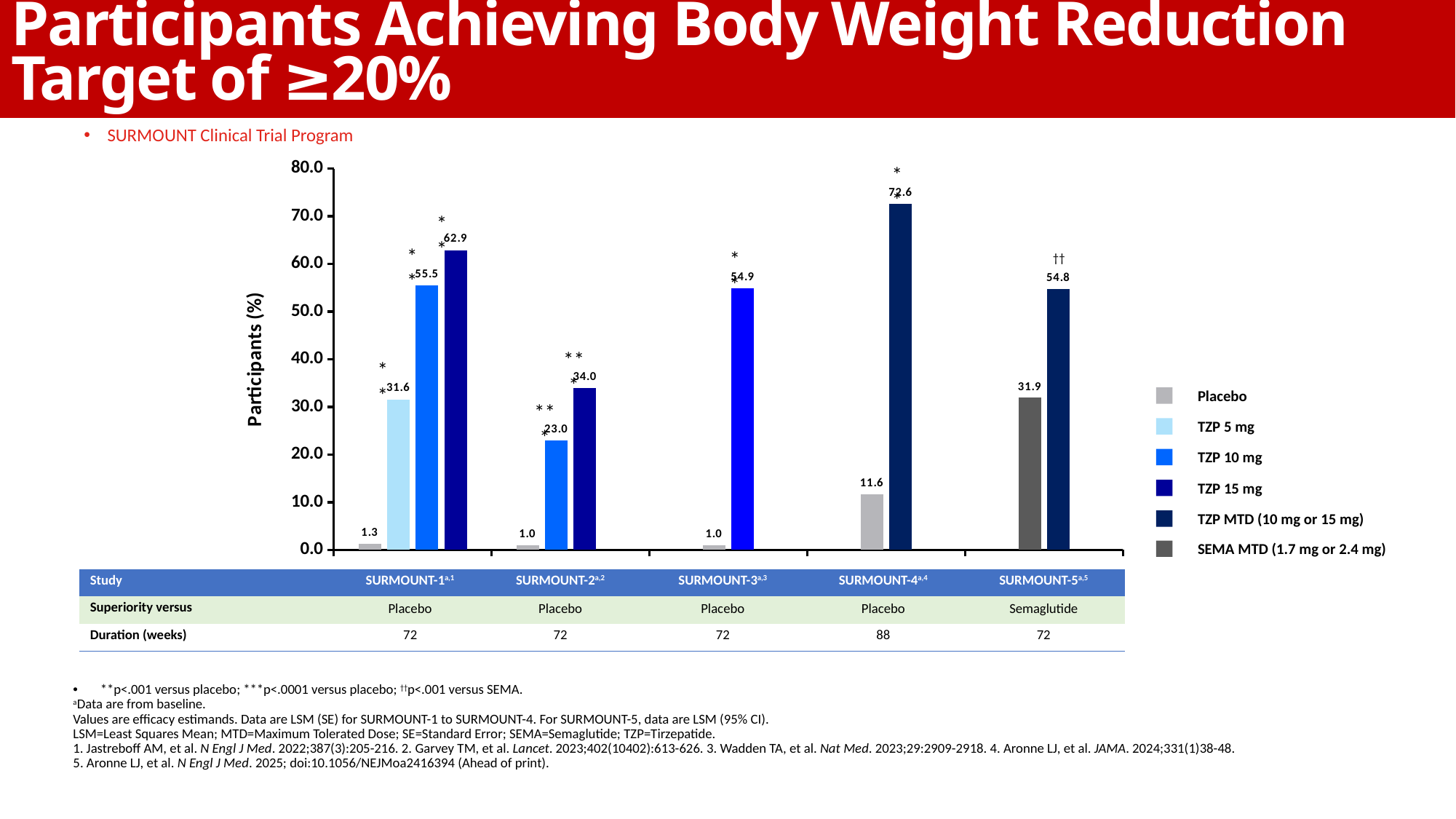
What is the value for TZP 15 mg in SURMOUNT-1? 62.9 What is the difference between TZP MTD and SEMA MTD in SURMOUNT-5? 22.9 What is the difference between TZP 15 mg and TZP 10 mg in SURMOUNT-1? 7.4 Which bar in SURMOUNT-1 has the lowest value? Placebo What is the value for TZP 10 mg in SURMOUNT-2? 23.0 What is the value for Placebo in SURMOUNT-4? 11.6 What is the label of the y axis? Participants (%) Which study has the highest plotted value? SURMOUNT-4 What is the value for SEMA MTD in SURMOUNT-5? 31.9 What kind of chart is shown on the slide? Bar chart How many series does the legend list? 6 Which is larger: TZP 15 mg in SURMOUNT-2 or TZP 5 mg in SURMOUNT-1? TZP 15 mg in SURMOUNT-2